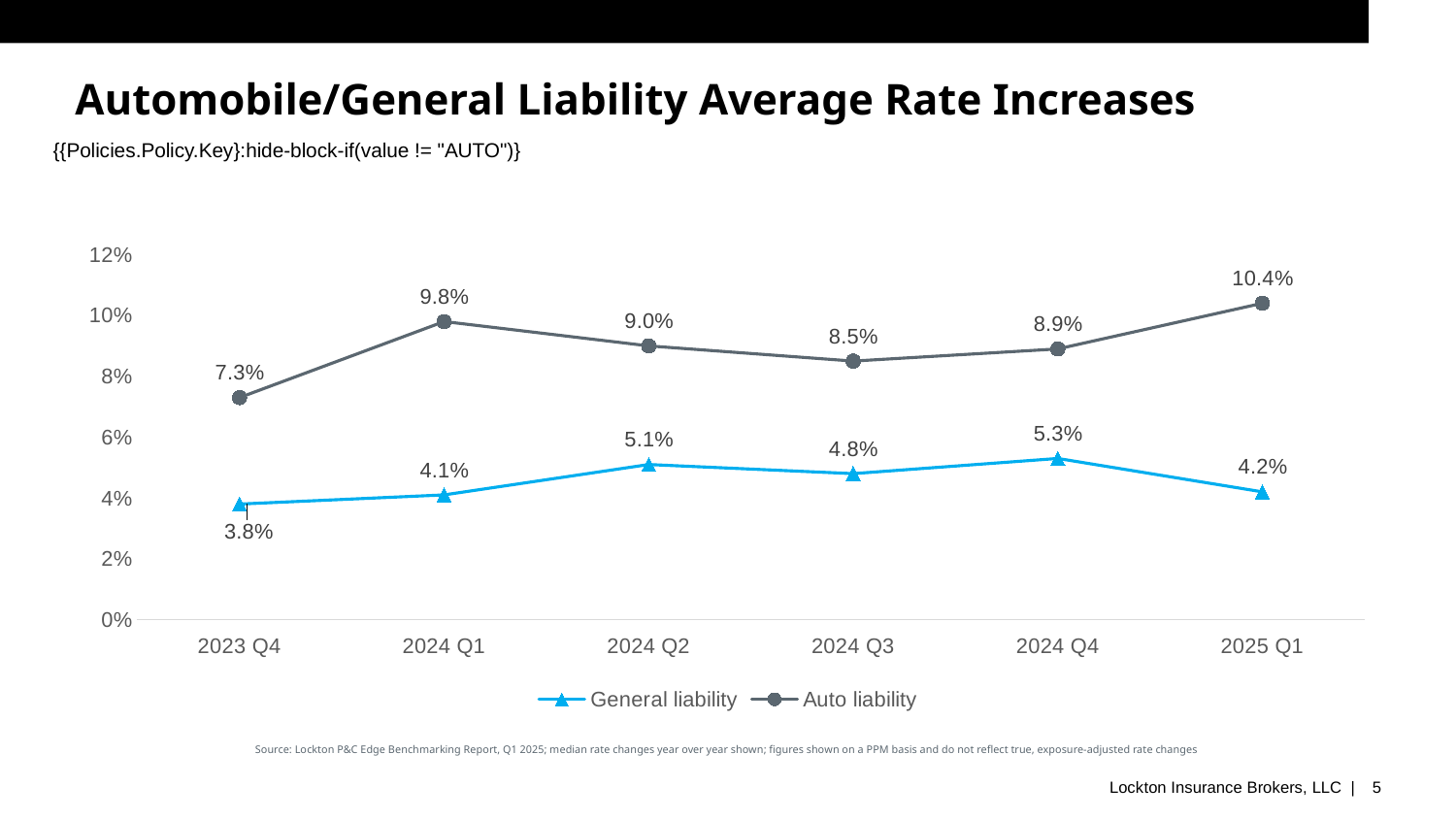
What is the difference between the Auto liability and General liability values in 2025 Q1? 6.2% In which quarter is the General liability value lowest? 2023 Q4 What is the Auto liability value for 2025 Q1? 10.4% How many series does the legend list? 2 How many quarters are shown on the x axis? 6 In which quarter is the Auto liability value highest? 2025 Q1 Which is larger in 2024 Q1: the Auto liability value or the General liability value? Auto liability What is the Auto liability value for 2024 Q3? 8.5% Does the General liability value rise or fall from 2024 Q4 to 2025 Q1? Fall What kind of chart is shown on the slide? Line chart What is the General liability value for 2023 Q4? 3.8% What is the General liability value for 2024 Q4? 5.3%